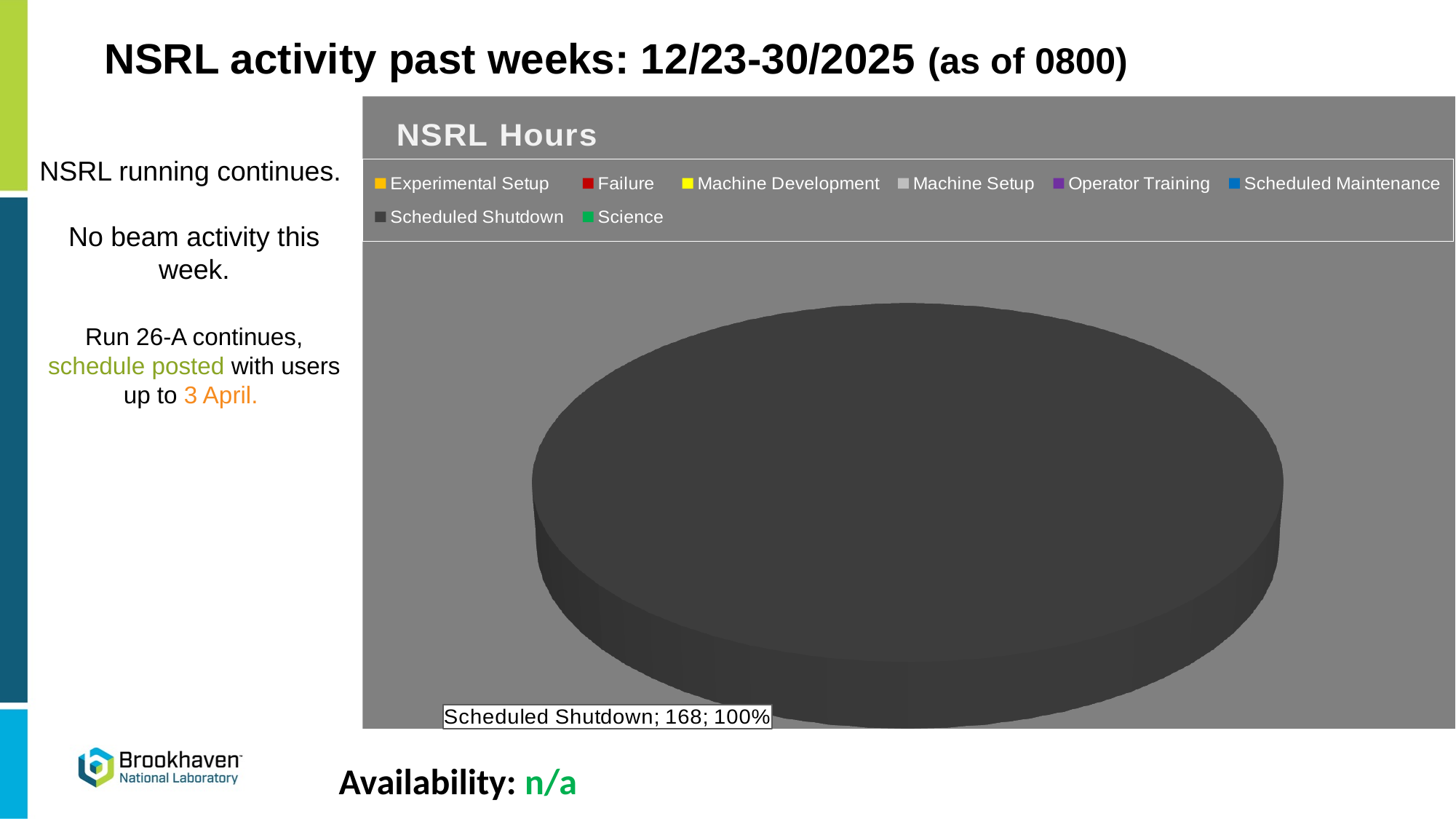
Which legend entry is shown in green? Science What share of the pie does Scheduled Shutdown take? 100% How many entries does the chart's legend list? 8 Is the value for Scheduled Shutdown greater or less than 100? greater How many slices are visible in the pie? 1 Which category has the largest slice of the pie? Scheduled Shutdown What kind of chart is shown on the slide? pie chart How many hours are shown for Scheduled Shutdown? 168 What is the title of the chart? NSRL Hours